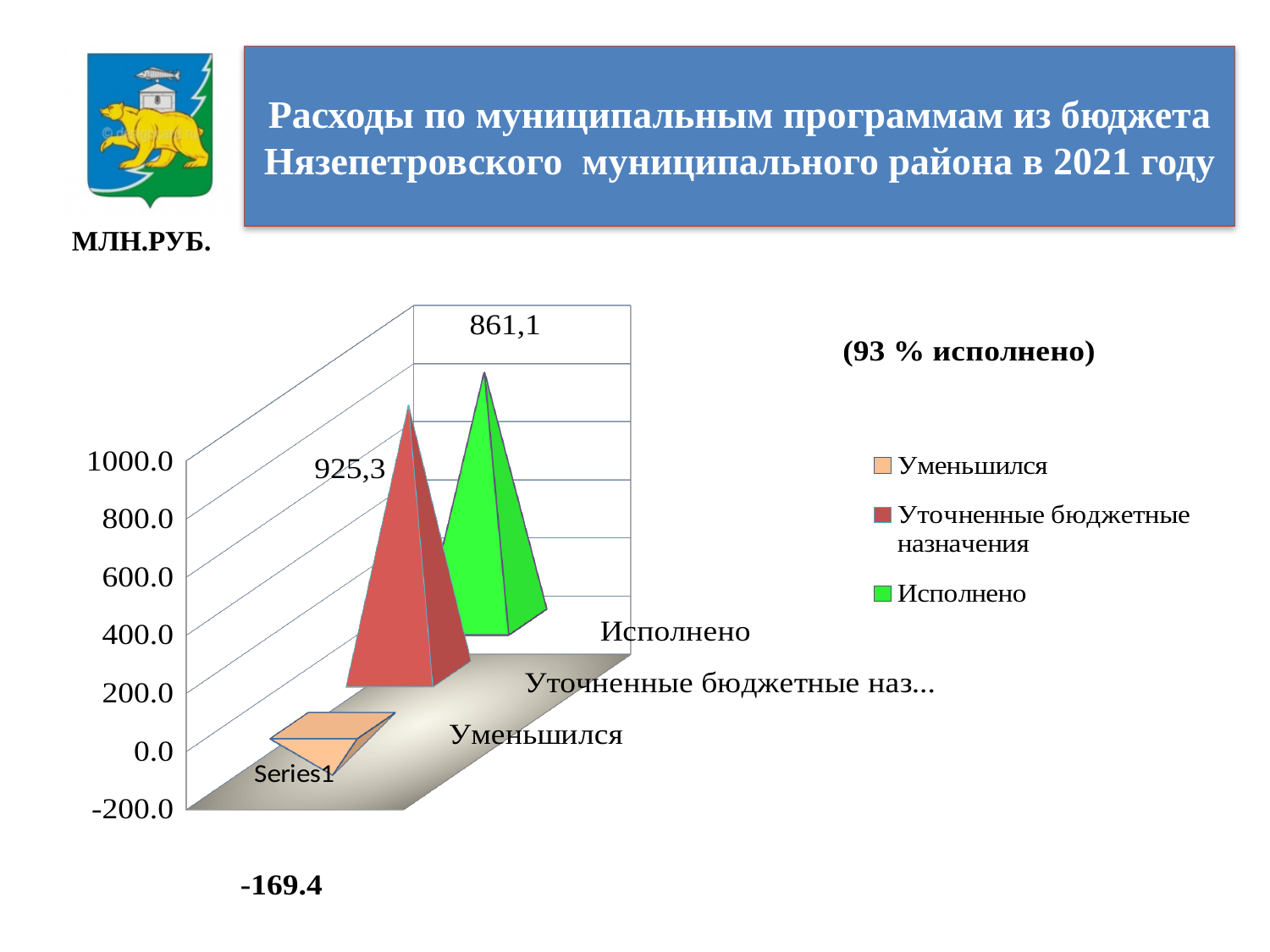
Which category has the lowest value? Уменьшился What is the value for Исполнено? 861,1 Which category has the highest value? Уточненные бюджетные назначения What is the value for Уменьшился? -169.4 What unit of measurement is indicated for the chart values? МЛН.РУБ. What kind of chart is shown on the slide? bar chart What is the difference between the values for Уточненные бюджетные назначения and Исполнено? 64,2 What is the value for Уточненные бюджетные назначения? 925,3 How many categories are shown in the chart? 3 Is the value for Исполнено greater or less than 800.0? greater How many entries does the legend list? 3 Which is larger, the value for Исполнено or the value for Уточненные бюджетные назначения? Уточненные бюджетные назначения